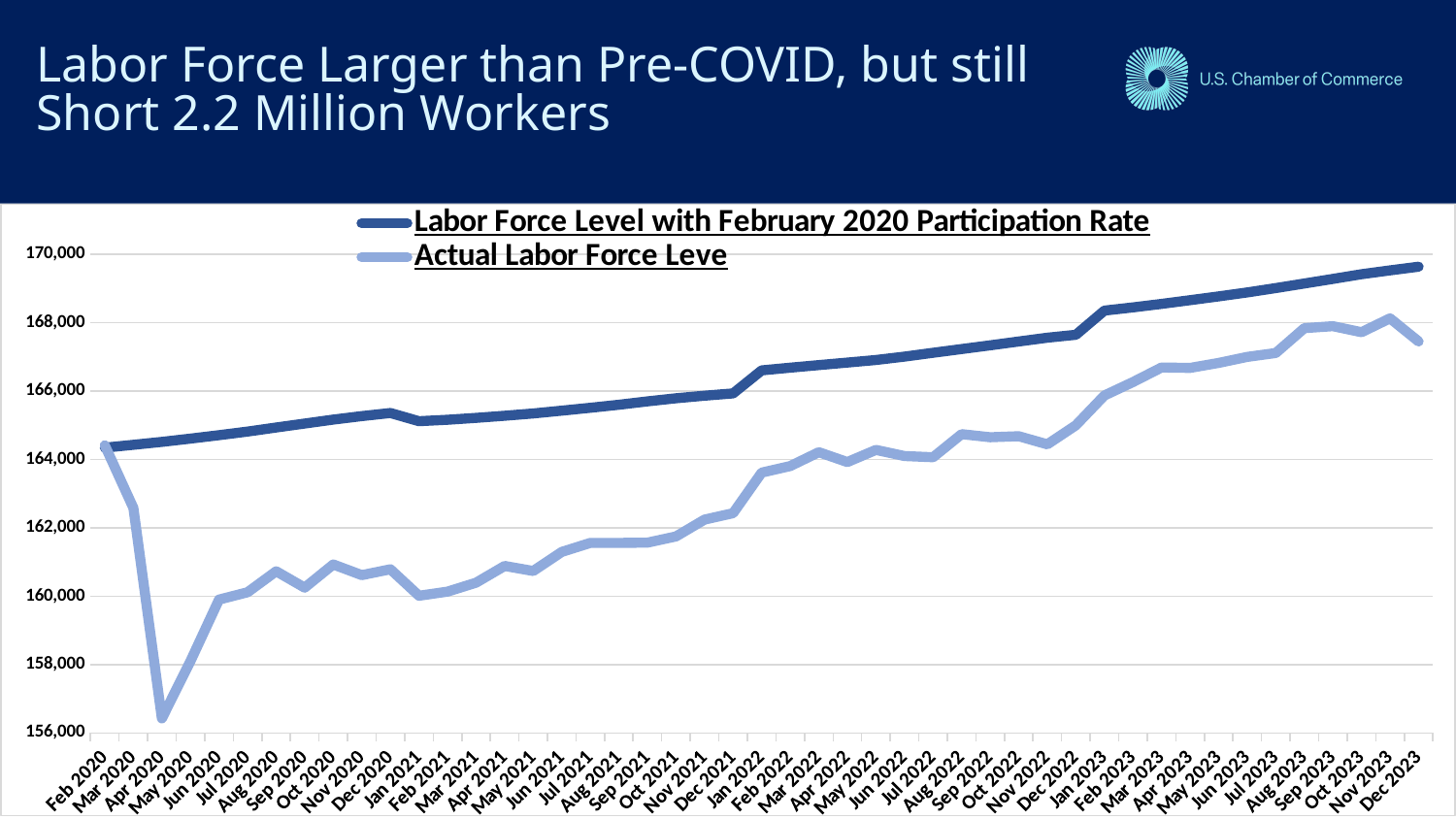
How many series does the legend list? 2 Is the Labor Force Level with February 2020 Participation Rate in Dec 2020 greater or less than 164,000? greater In which month does the Actual Labor Force Level reach its lowest point? Apr 2020 In which month does the Labor Force Level with February 2020 Participation Rate reach its highest point? Dec 2023 What are the two series named in the legend? Labor Force Level with February 2020 Participation Rate; Actual Labor Force Leve What kind of chart is shown on the slide? Line chart What is the first month shown on the x axis? Feb 2020 Is the Actual Labor Force Level in Jan 2022 greater or less than 164,000? less In Apr 2020, which series has the higher value: the Labor Force Level with February 2020 Participation Rate or the Actual Labor Force Level? Labor Force Level with February 2020 Participation Rate Is the Labor Force Level with February 2020 Participation Rate in Dec 2023 greater or less than 168,000? greater Does the Labor Force Level with February 2020 Participation Rate generally rise or fall from Feb 2020 to Dec 2023? Rise